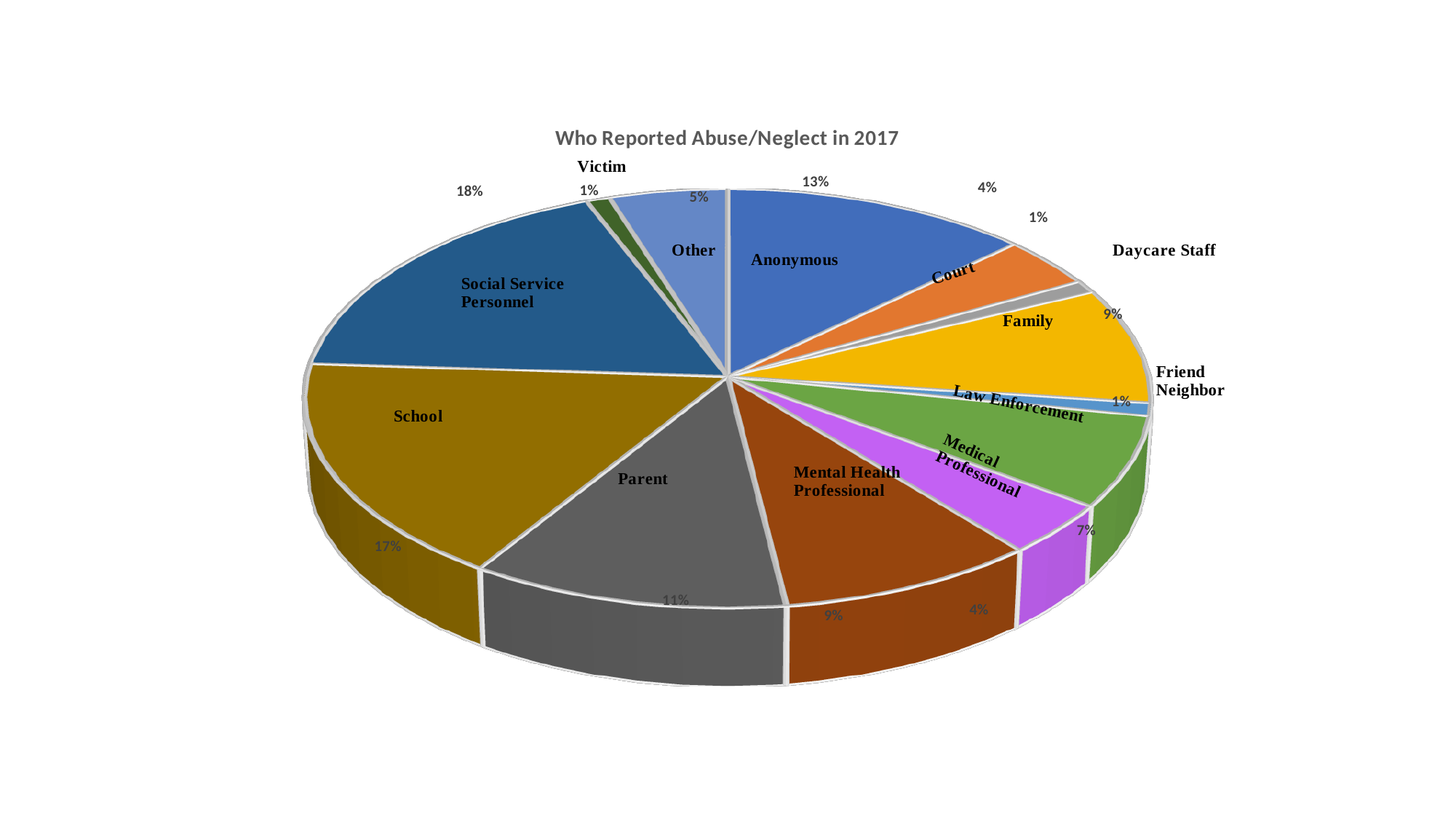
What percentage of reports were Anonymous? 13% What type of chart is shown on the slide? Pie chart What percentage of reports came from Law Enforcement? 7% How many categories (slices) does the pie chart have? 13 What is the difference in percentage points between School and Parent? 6 Which reporter category has the largest share of the pie? Social Service Personnel What is the combined share of Mental Health Professional and Medical Professional? 13% What percentage of reports came from School? 17% What percentage of reports came from Social Service Personnel? 18% What is the title of the chart? Who Reported Abuse/Neglect in 2017 Which is larger, the share for Family or the share for Court? Family What percentage of reports came from a Parent? 11%